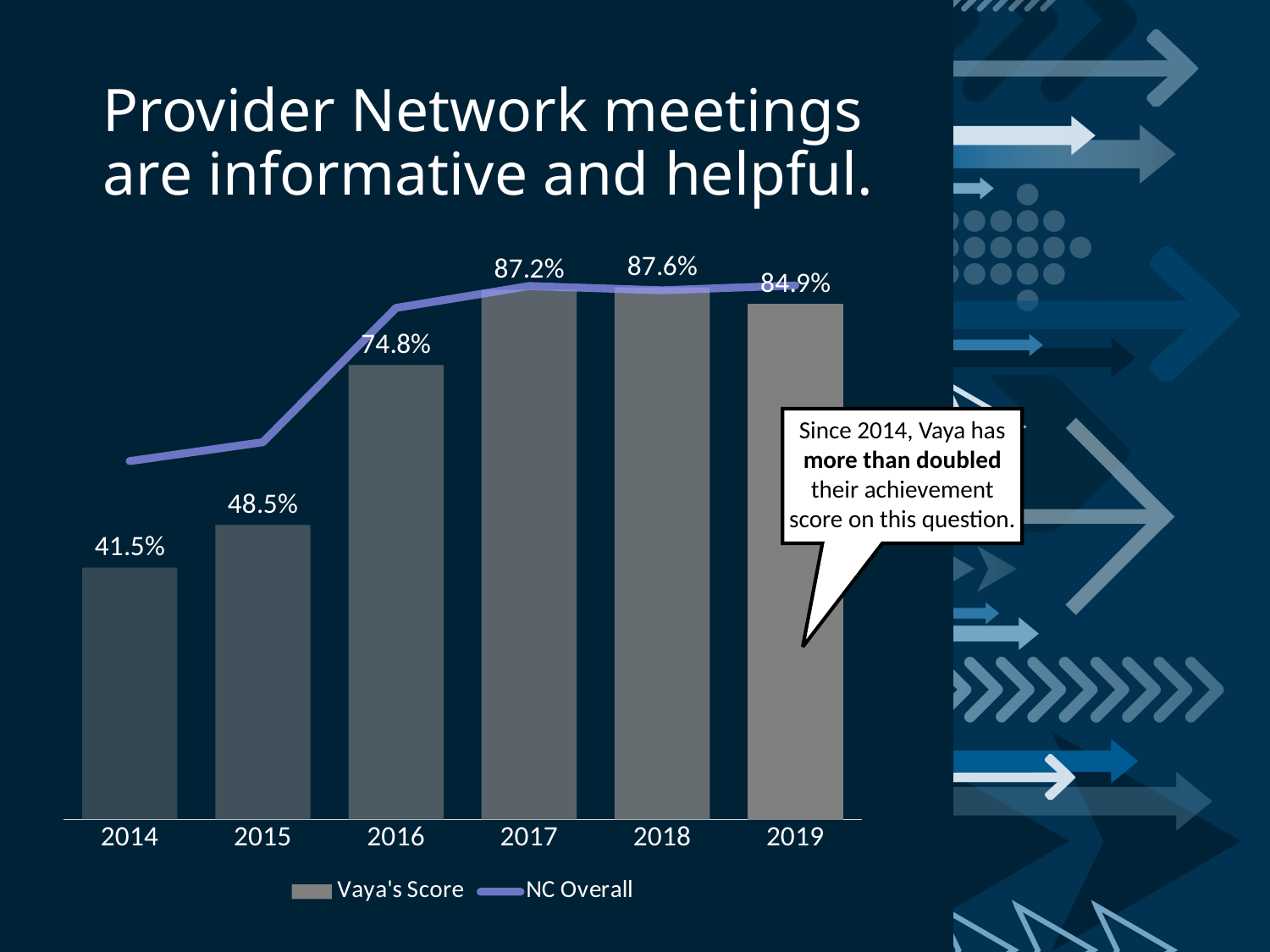
How many years are shown on the x axis? 6 Does Vaya's Score rise or fall from 2014 to 2018? Rise How many series does the legend list? 2 What is Vaya's Score for 2019? 84.9% Which is larger, Vaya's Score in 2017 or in 2019? 2017 What is Vaya's Score for 2016? 74.8% What is Vaya's Score for 2014? 41.5% What kind of chart is used to show Vaya's Score? Bar chart In which year is Vaya's Score lowest? 2014 What is the difference between Vaya's Score in 2016 and in 2015? 26.3% What is the difference between Vaya's Score in 2019 and in 2014? 43.4% In which year is Vaya's Score highest? 2018